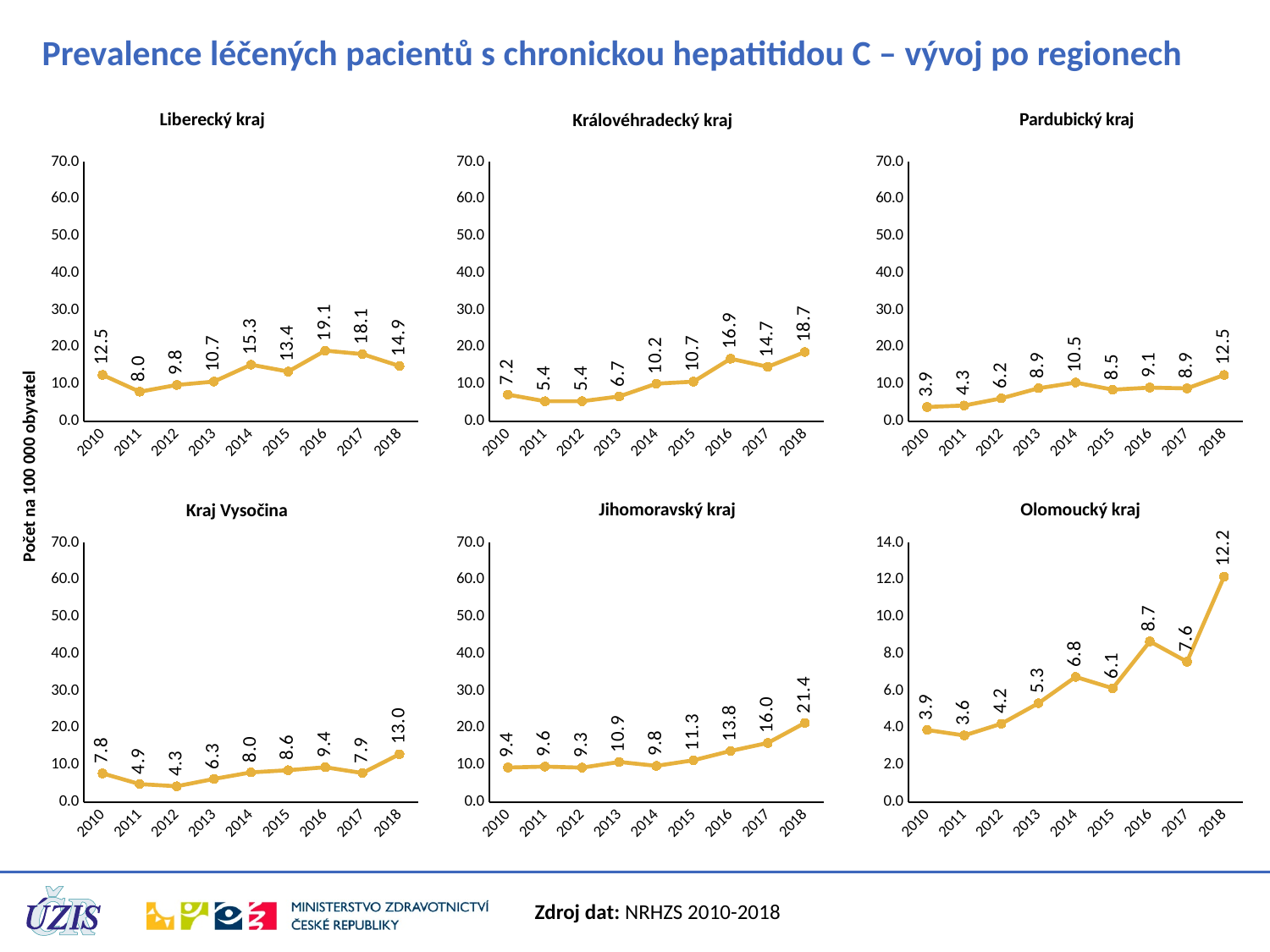
In the Královéhradecký kraj chart, which year has the highest value? 2018 What is the y-axis label shared by the charts on the slide? Počet na 100 000 obyvatel What type of chart is used for Liberecký kraj? Line chart In the Jihomoravský kraj chart, do the values generally rise or fall from 2013 to 2018? Rise In the Pardubický kraj chart, which year has the lowest value? 2010 In the Kraj Vysočina chart, what is the difference between the values for 2018 and 2012? 8.7 In the Královéhradecký kraj chart, is the value for 2016 greater or less than 10.0? greater How many regional charts are shown on the slide? 6 In the Liberecký kraj chart, what is the value for 2016? 19.1 In the Olomoucký kraj chart, what is the value for 2018? 12.2 How many data points are plotted in the Jihomoravský kraj chart? 9 In the Jihomoravský kraj chart, is the value for 2017 larger than the value for 2013? Yes, 2017 (16.0) is larger than 2013 (10.9)